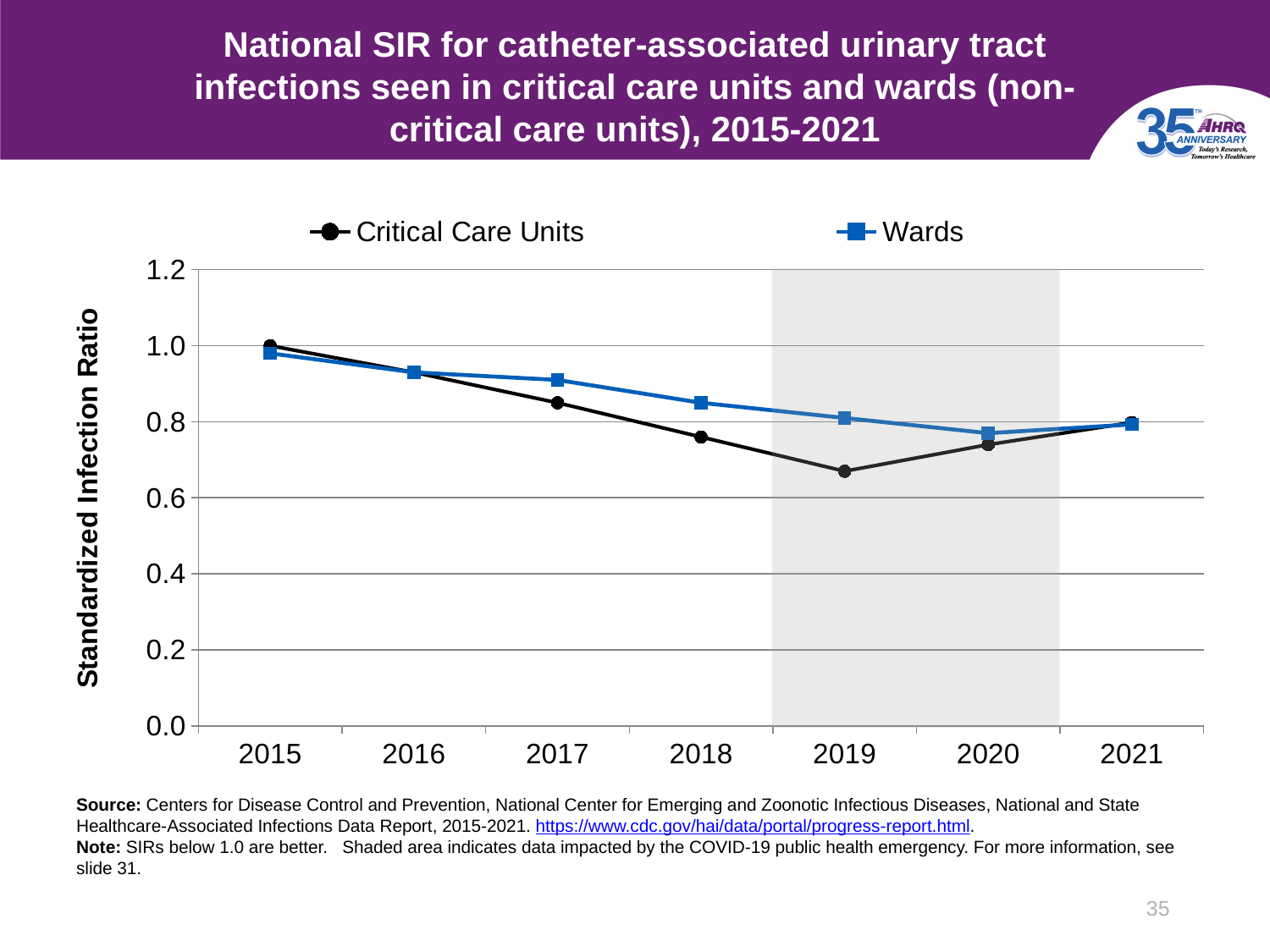
In which year is the Critical Care Units SIR lowest? 2019 Is the Critical Care Units value for 2019 greater or less than 0.8? less How many years are plotted along the x axis? 7 In 2017, which series has the higher SIR, Critical Care Units or Wards? Wards In which year is the Critical Care Units SIR highest? 2015 In which year is the Wards SIR highest? 2015 What kind of chart is shown on the slide? Line chart How many series does the legend list? 2 In 2019, which series has the higher SIR, Critical Care Units or Wards? Wards Is the Wards value for 2017 greater or less than 0.8? greater What is the label on the vertical axis? Standardized Infection Ratio Does the Critical Care Units SIR rise or fall from 2015 to 2019? Fall